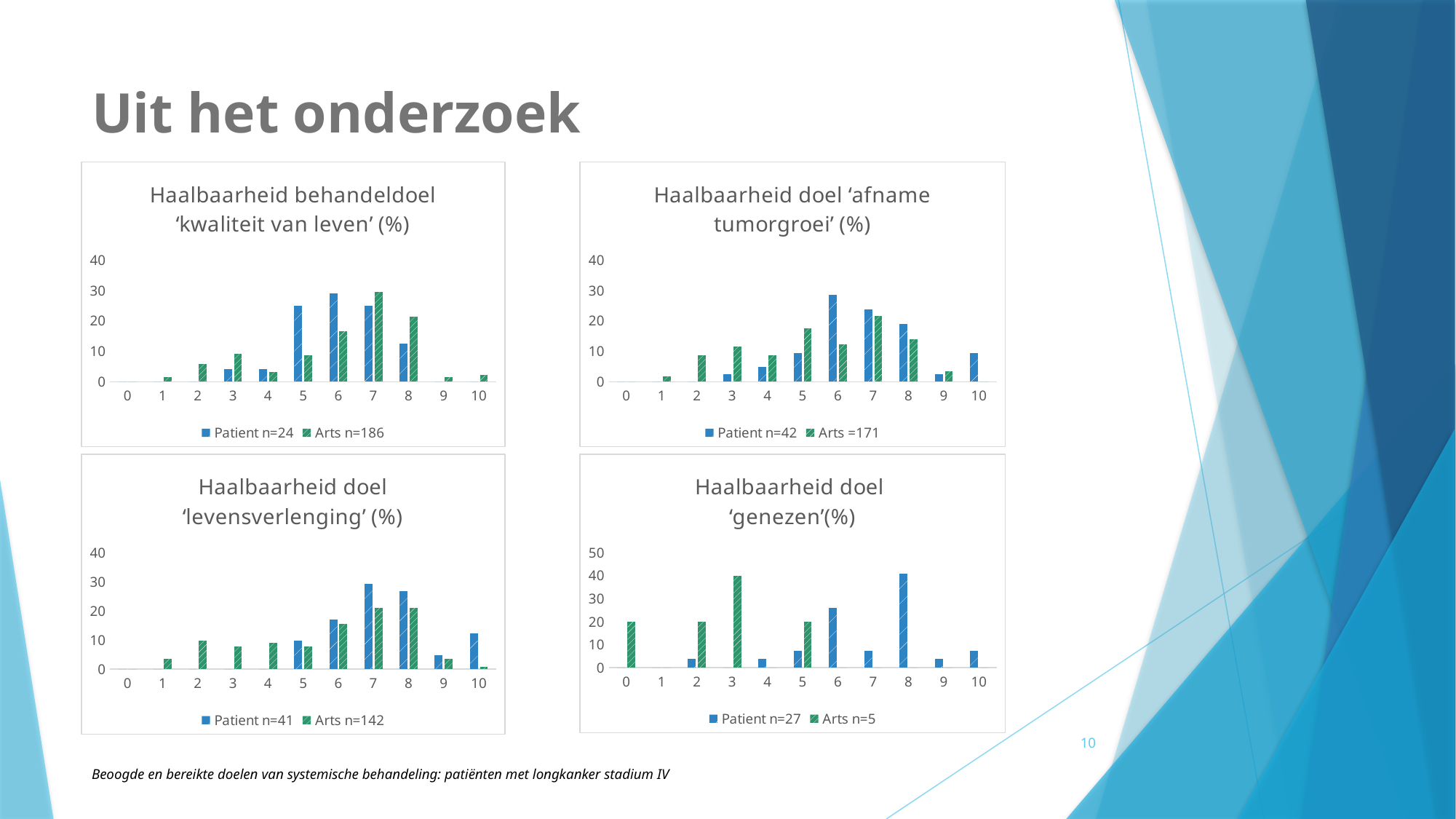
In the chart 'Haalbaarheid doel ‘levensverlenging’ (%)', is the value for Patient n=41 at score 7 greater or less than 20? greater In the chart 'Haalbaarheid behandeldoel ‘kwaliteit van leven’ (%)', at score 7, which series has the larger value, Patient n=24 or Arts n=186? Arts n=186 In the chart 'Haalbaarheid doel ‘genezen’(%)', is the value for Arts n=5 at score 3 greater or less than 30? greater In the chart 'Haalbaarheid doel ‘genezen’(%)', which score has the highest value for the Patient n=27 series? 8 In the chart 'Haalbaarheid behandeldoel ‘kwaliteit van leven’ (%)', which score has the highest value for the Arts n=186 series? 7 In the chart 'Haalbaarheid doel ‘levensverlenging’ (%)', at score 10, which series has the larger value, Patient n=41 or Arts n=142? Patient n=41 In the chart 'Haalbaarheid doel ‘afname tumorgroei’ (%)', how many series does the legend list? 2 In the chart 'Haalbaarheid behandeldoel ‘kwaliteit van leven’ (%)', which score has the highest value for the Patient n=24 series? 6 How many score categories are shown on the x axis of the chart 'Haalbaarheid doel ‘genezen’(%)'? 11 In the chart 'Haalbaarheid doel ‘afname tumorgroei’ (%)', is the value for Patient n=42 at score 6 greater or less than 20? greater What kind of chart is 'Haalbaarheid doel ‘levensverlenging’ (%)'? bar chart